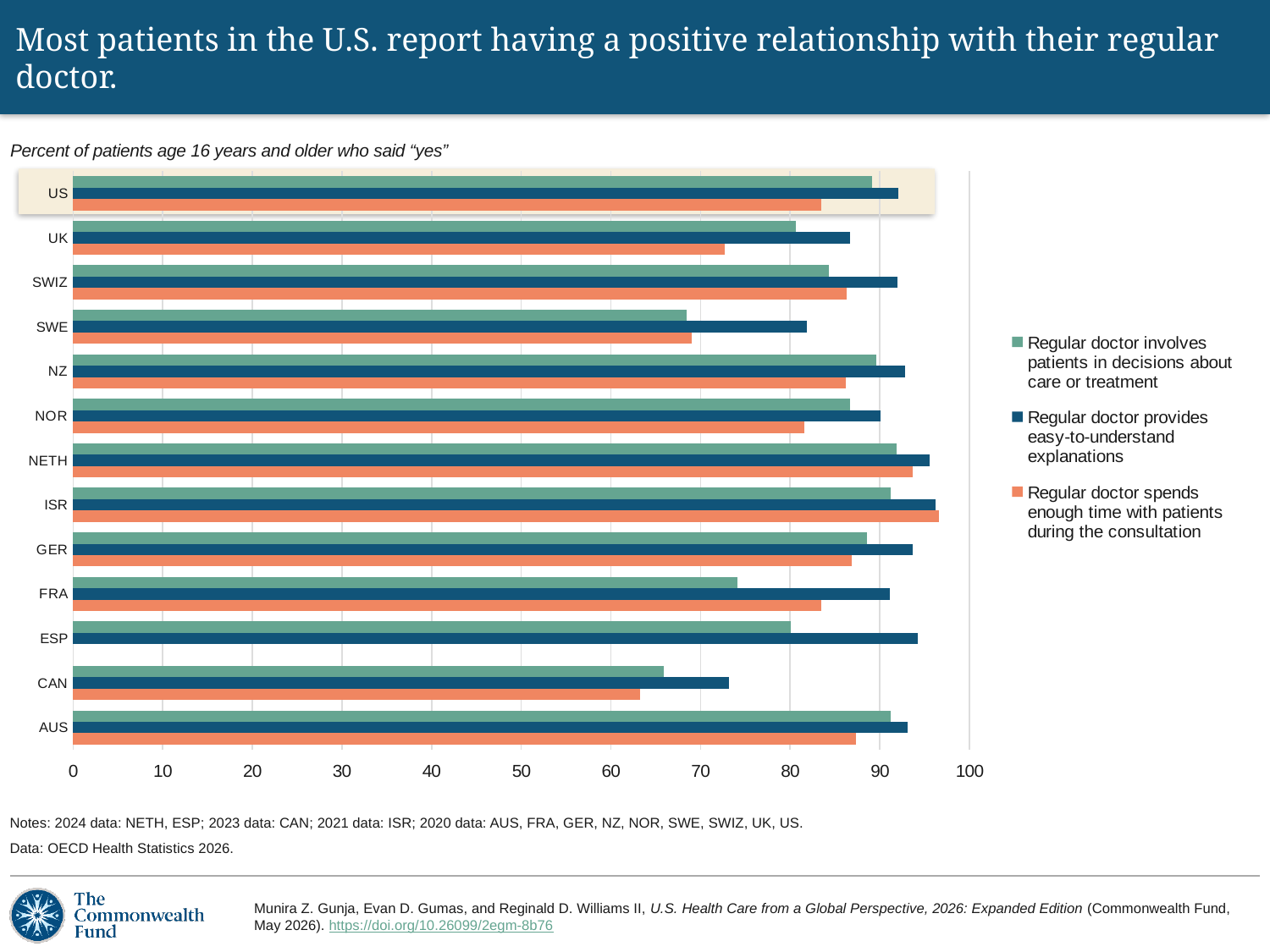
Which country has the lowest value for "Regular doctor involves patients in decisions about care or treatment"? CAN Which country has the highest value for "Regular doctor spends enough time with patients during the consultation"? ISR How many series does the legend list? 3 Which country has no bar shown for "Regular doctor spends enough time with patients during the consultation"? ESP How many countries are listed on the chart's vertical axis? 13 Which country has the lowest value for "Regular doctor provides easy-to-understand explanations"? CAN Is the value for CAN on "Regular doctor involves patients in decisions about care or treatment" greater or less than 70? less Is the value for US on "Regular doctor provides easy-to-understand explanations" greater or less than 90? greater For FRA, which is larger: "Regular doctor involves patients in decisions about care or treatment" or "Regular doctor provides easy-to-understand explanations"? Regular doctor provides easy-to-understand explanations For "Regular doctor spends enough time with patients during the consultation", which is larger: UK or SWIZ? SWIZ Is the value for FRA on "Regular doctor involves patients in decisions about care or treatment" greater or less than 70? greater What kind of chart is shown on the slide? bar chart